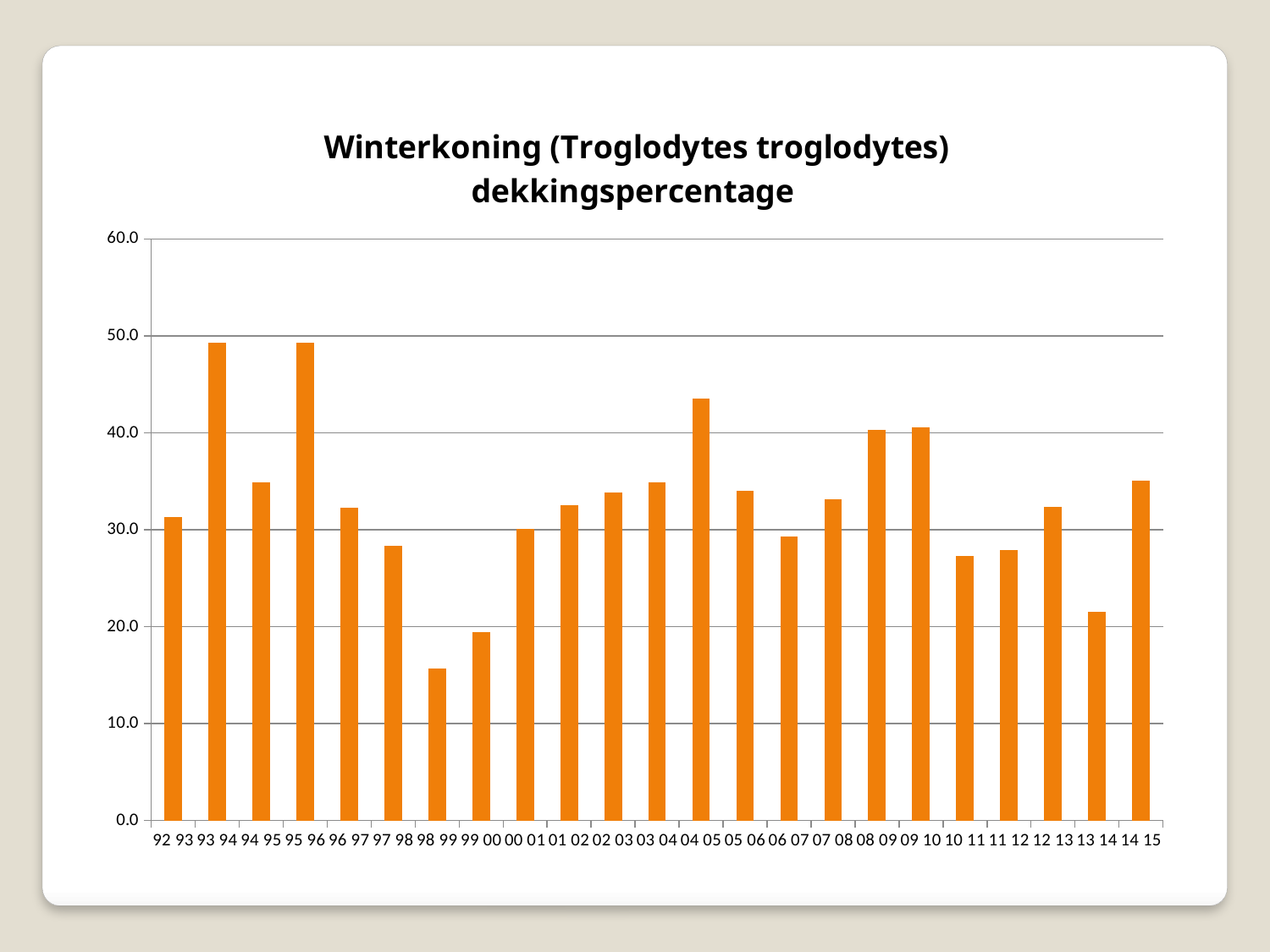
Which is larger, the value for 04 05 or the value for 05 06? 04 05 Which is larger, the value for 98 99 or the value for 99 00? 99 00 What is the title of the chart? Winterkoning (Troglodytes troglodytes) dekkingspercentage What kind of chart is shown on the slide? bar chart Is the value for 04 05 greater or less than 40? greater Which season has the lowest dekkingspercentage? 98 99 Do the values rise or fall from 98 99 to 04 05? rise Is the value for 10 11 greater or less than 30? less Is the value for 98 99 greater or less than 20? less How many bars (seasons) are plotted in the chart? 23 What colour are the bars in the chart? orange